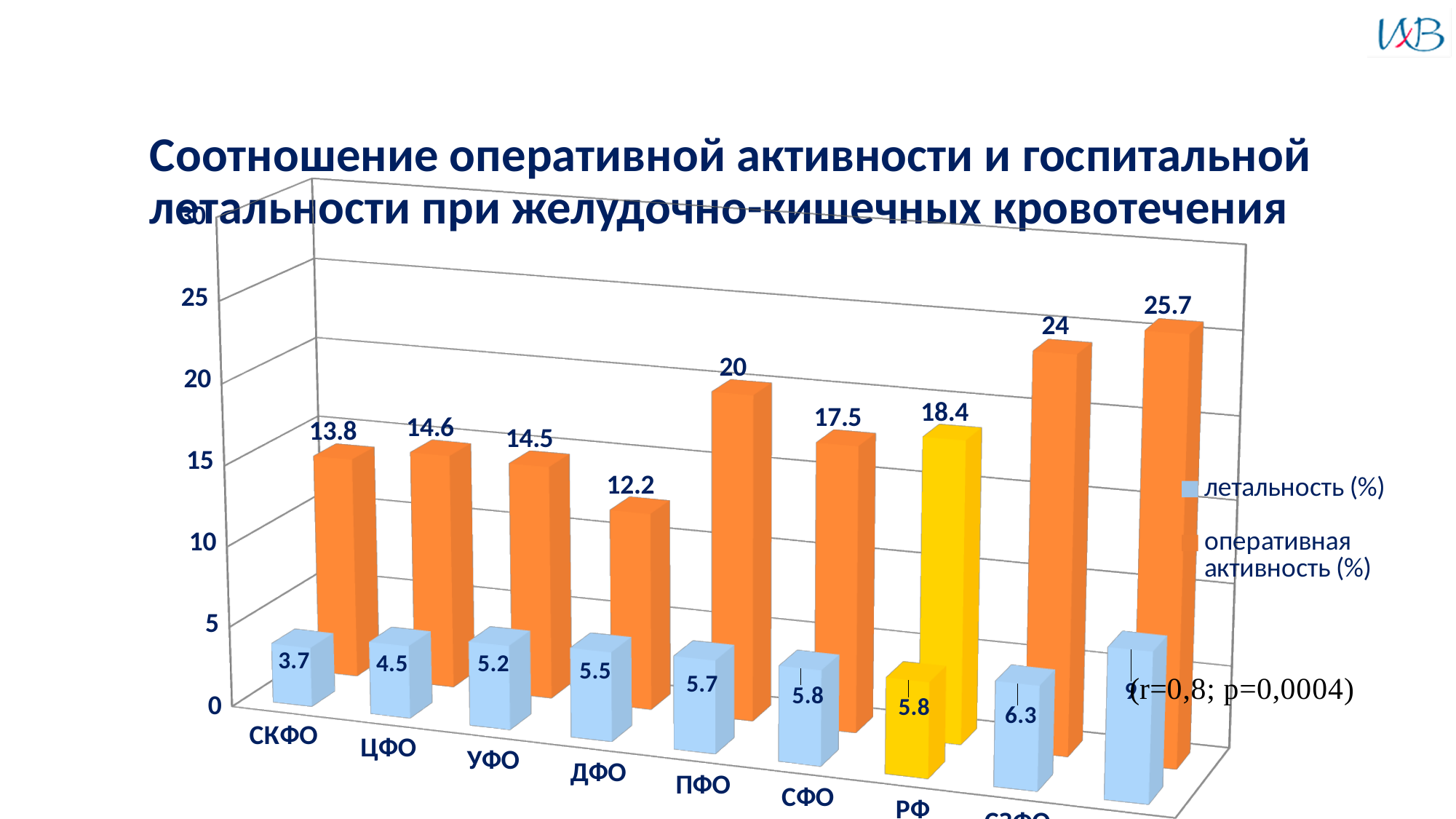
Which has the higher оперативная активность (%), СЗФО or СФО? СЗФО Do the летальность (%) values rise or fall from СКФО to СЗФО along the x axis? Rise What is the летальность (%) value for СЗФО? 6.3 What colour are the bars for the РФ category? Yellow What is the оперативная активность (%) value for РФ? 18.4 Which category has the lowest оперативная активность (%)? ДФО Which labelled category has the lowest летальность (%)? СКФО What is the летальность (%) value for СКФО? 3.7 What kind of chart is shown on the slide? Bar chart What is the оперативная активность (%) value for ПФО? 20 How many series does the legend list? 2 What is the difference in оперативная активность (%) between ПФО and СКФО? 6.2